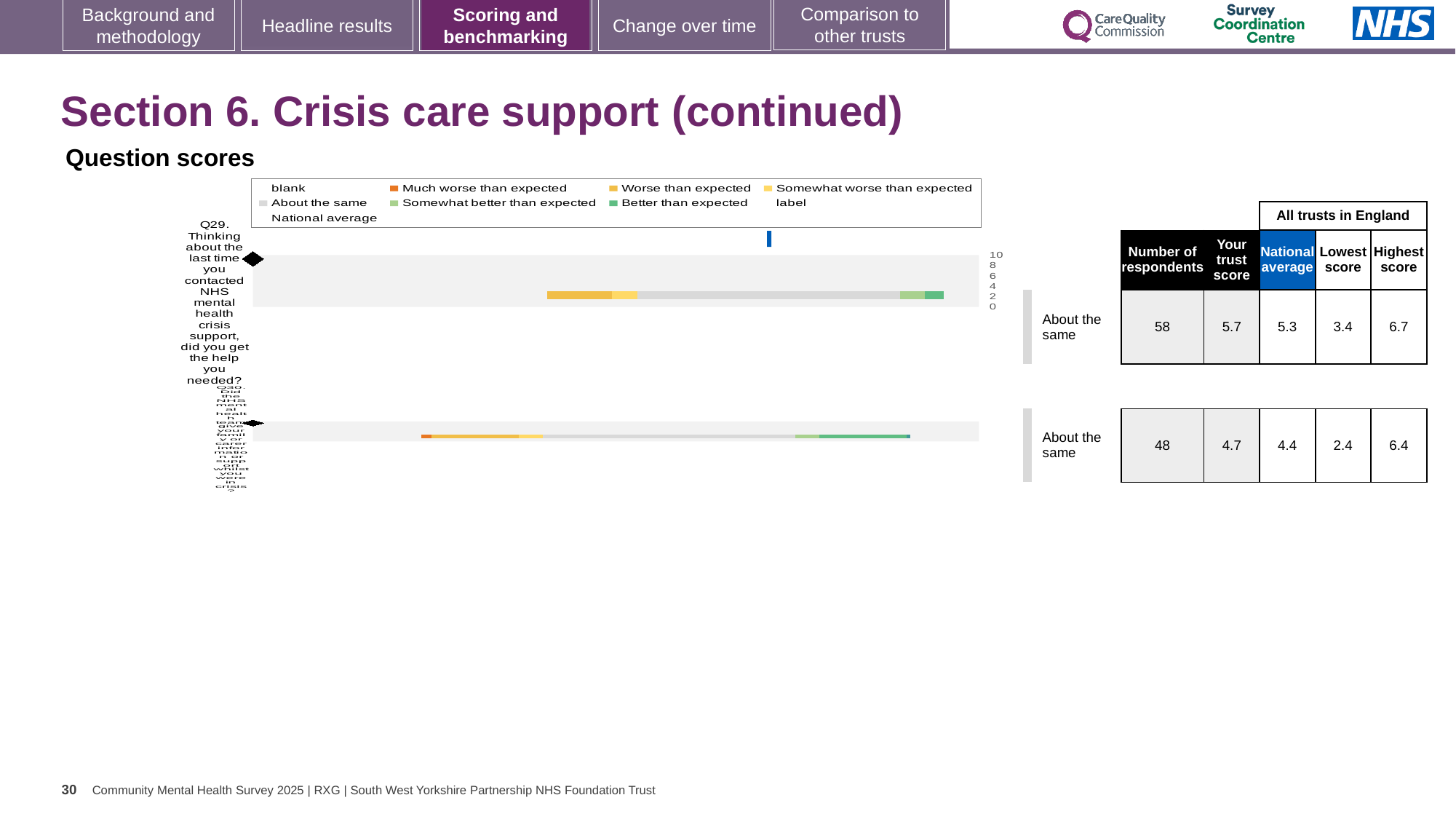
What is the difference between the highest and lowest scores across all trusts in England for Q30? 4.0 How many questions are plotted in the Question scores chart? 2 How many respondents answered Q30? 48 By how much does the trust's score for Q29 exceed the national average for Q29? 0.4 What is the highest score across all trusts in England for Q29? 6.7 What is the lowest score across all trusts in England for Q30? 2.4 What is the national average score for Q29? 5.3 Which question has the higher 'Your trust score', Q29 or Q30? Q29 What benchmark category is shown for Q29 next to the chart? About the same What is the 'Your trust score' for Q29 (Thinking about the last time you contacted NHS mental health crisis support, did you get the help you needed?)? 5.7 What kind of chart is used to show the question scores? Bar chart What is the heading above the chart? Question scores